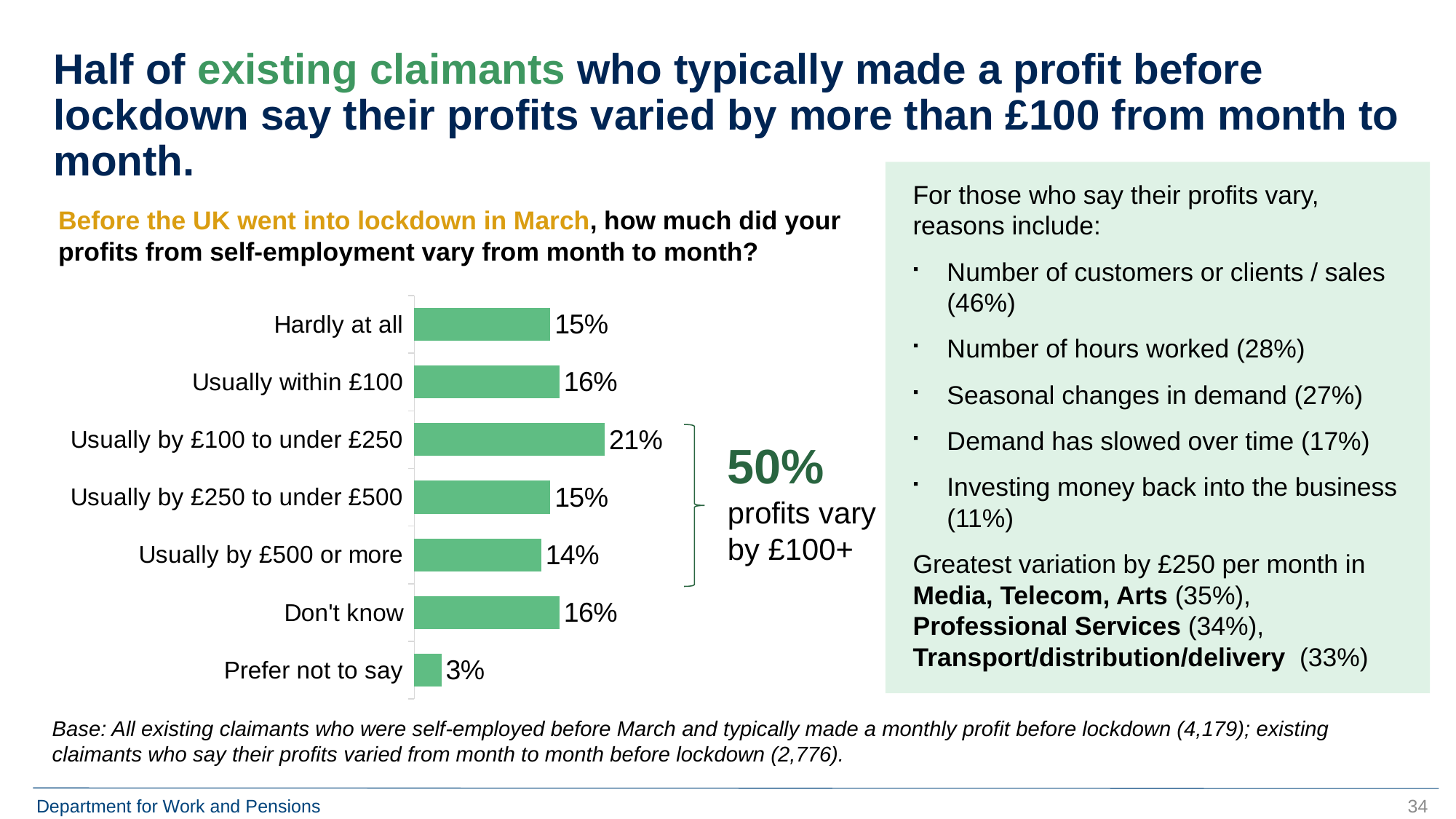
What percentage of respondents said their profits varied 'Usually by £100 to under £250'? 21% Which category has the lowest percentage in the chart? Prefer not to say What is the combined percentage of the three categories bracketed as 'profits vary by £100+'? 50% How many categories are shown in the bar chart? 7 What percentage of respondents answered 'Prefer not to say'? 3% What is the difference in percentage points between 'Usually by £100 to under £250' and 'Usually by £500 or more'? 7 percentage points What type of chart is shown on the slide? Bar chart What percentage of respondents said their profits varied 'Hardly at all'? 15% Which category has the highest percentage in the chart? Usually by £100 to under £250 What percentage of respondents answered 'Don't know'? 16% What colour are the bars in the chart? Green Which is larger: the value for 'Usually within £100' or the value for 'Usually by £500 or more'? Usually within £100